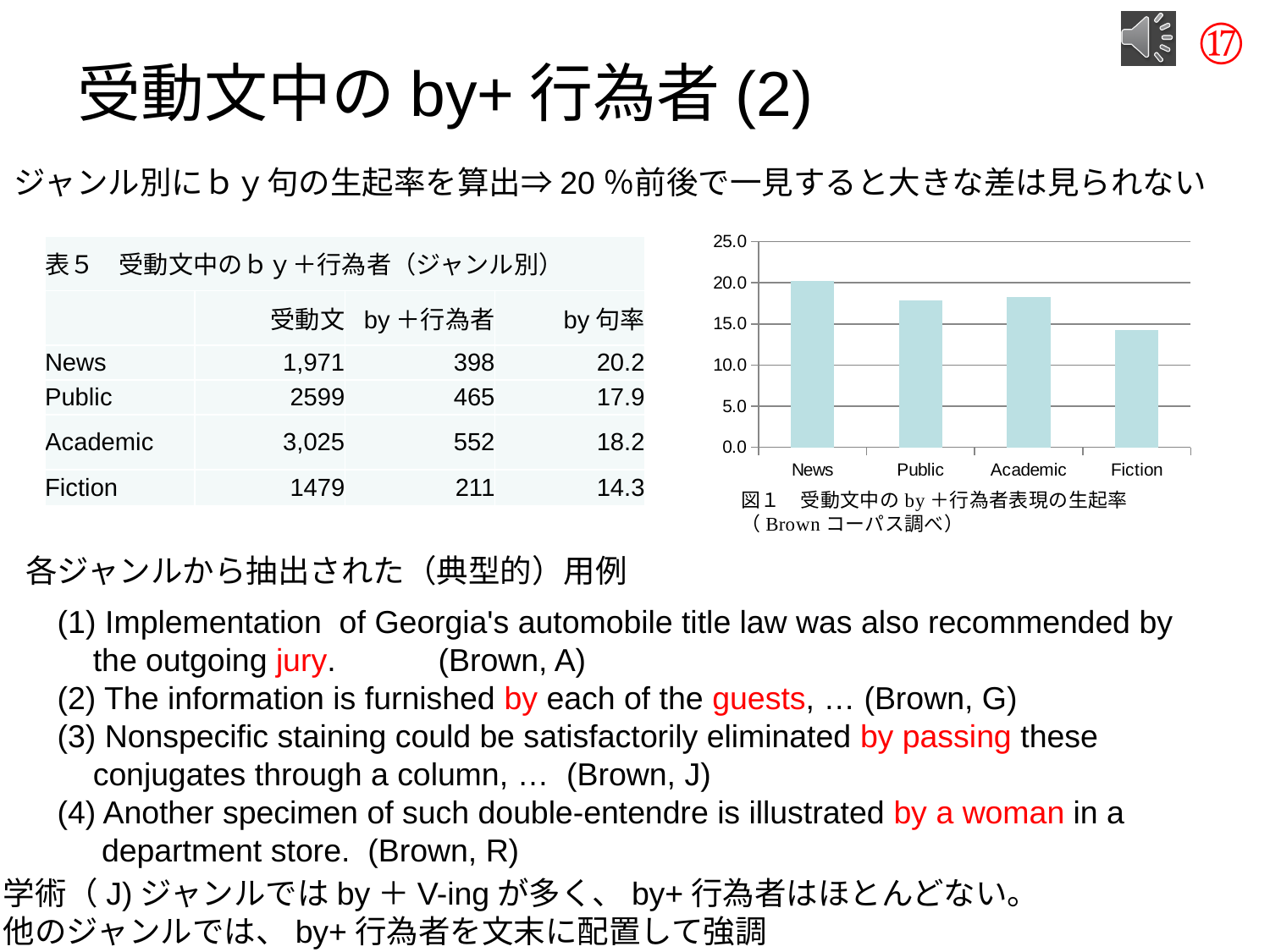
In the chart, which bar is taller, Academic or Fiction? Academic Which category has the shortest bar in the chart? Fiction What is the highest tick value shown on the y axis of the chart? 25.0 What is the label of the first category on the x axis of the chart? News How many categories are shown on the x axis of the bar chart? 4 Is the value for Fiction in the chart greater or less than 15.0? less Which category has the tallest bar in the chart? News What kind of chart is shown on the right side of the slide? bar chart Is the value for Public in the chart greater or less than 20.0? less In the chart, is the bar for News taller or shorter than the bar for Fiction? taller Is the value for News in the chart greater or less than 15.0? greater